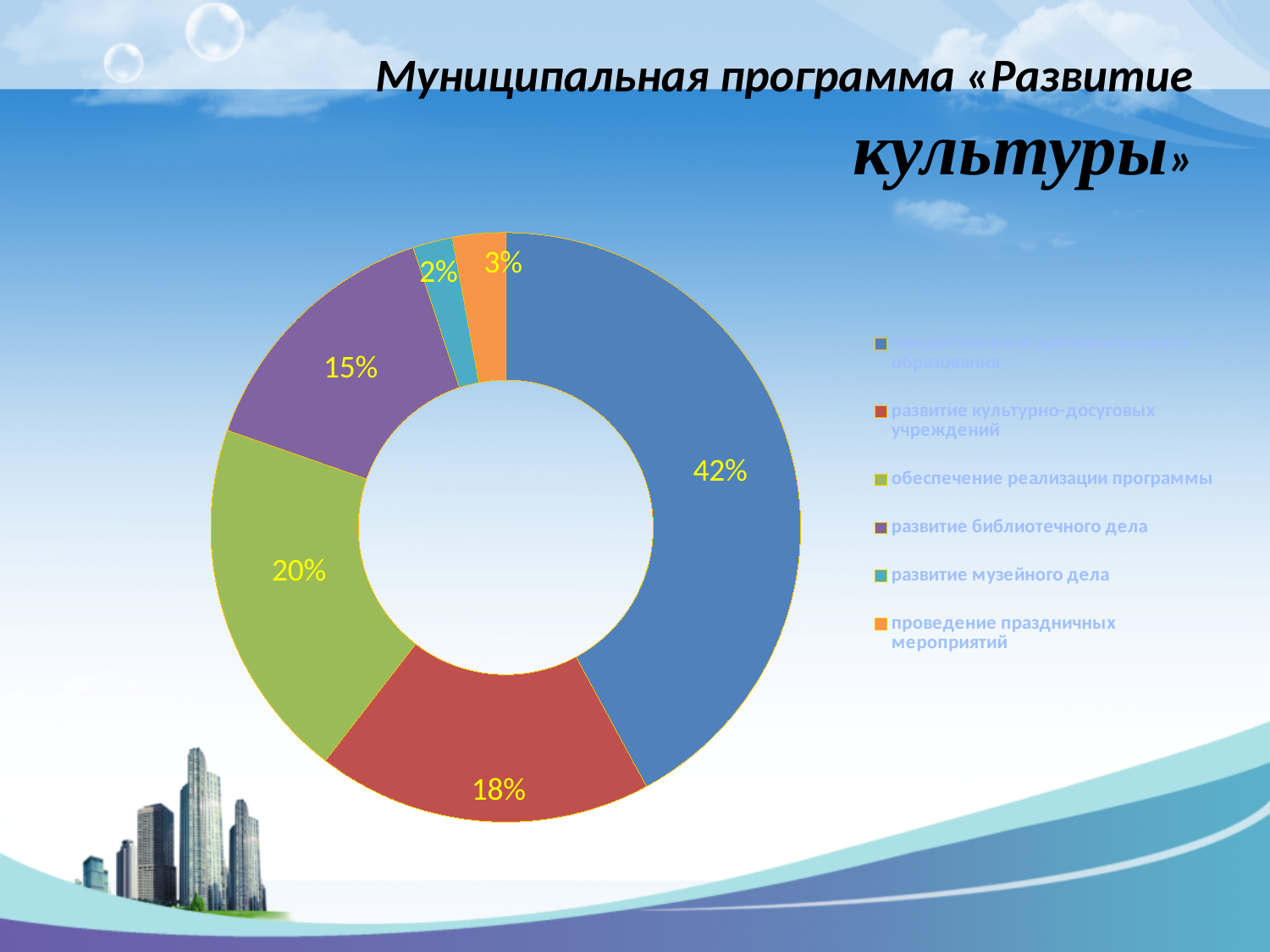
How many slices does the chart have? 6 What type of chart is shown on the slide? doughnut (pie) chart Which category has the smallest slice in the chart? развитие музейного дела What percentage does the slice for «обеспечение реализации программы» show? 20% What colour is the slice for «развитие библиотечного дела»? purple What percentage does the slice for «развитие библиотечного дела» show? 15% What is the percentage shown on the largest slice of the chart? 42% Which is larger: «развитие культурно-досуговых учреждений» or «обеспечение реализации программы»? обеспечение реализации программы What percentage does the slice for «проведение праздничных мероприятий» show? 3% What percentage does the slice for «развитие культурно-досуговых учреждений» show? 18% What percentage does the slice for «развитие музейного дела» show? 2% By how many percentage points does «обеспечение реализации программы» exceed «развитие библиотечного дела»? 5 percentage points